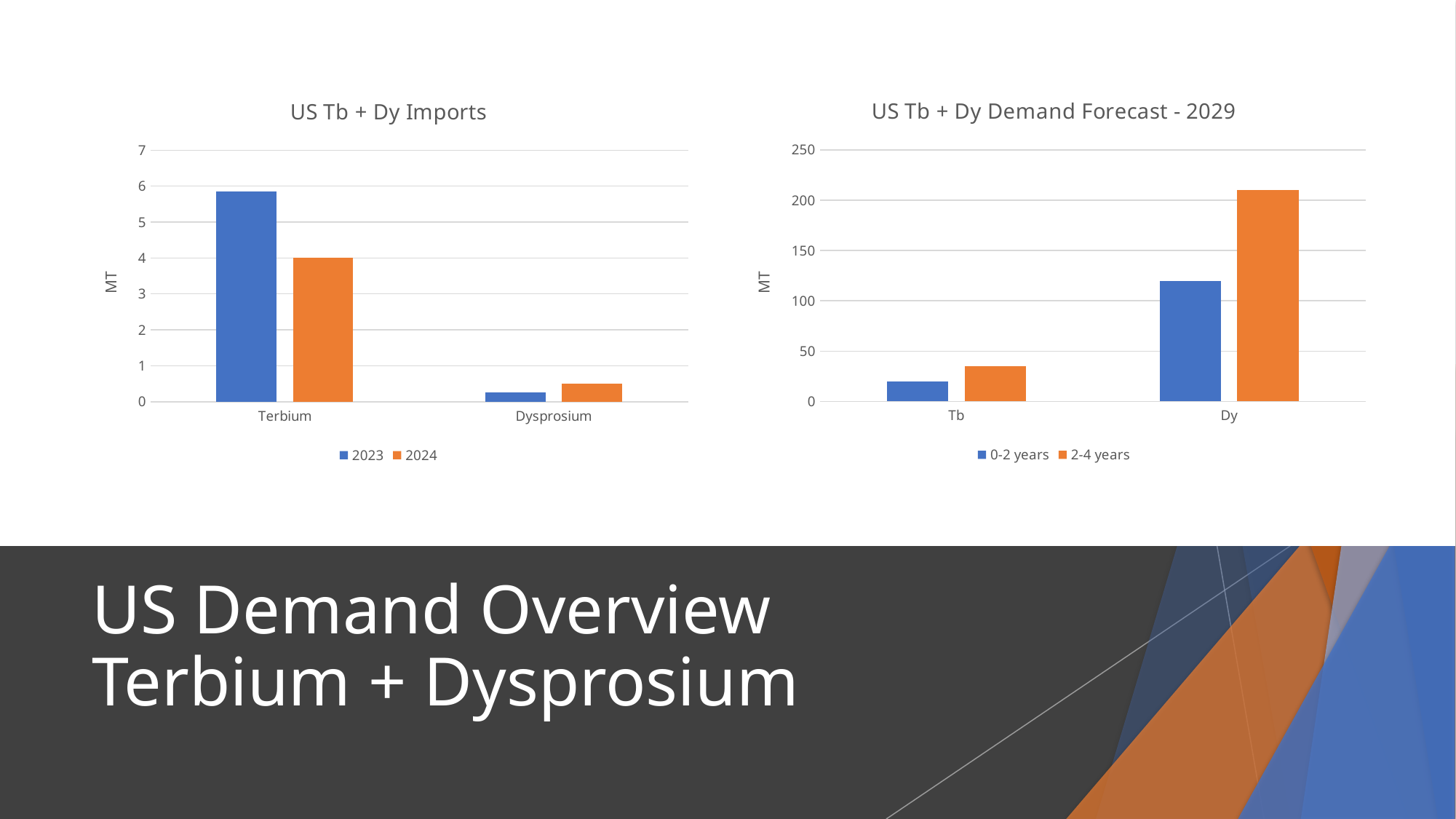
In the 'US Tb + Dy Demand Forecast - 2029' chart, which category has the lowest 0-2 years value? Tb In the 'US Tb + Dy Imports' chart, what kind of chart is shown? bar chart In the 'US Tb + Dy Imports' chart, which is larger for Terbium, the 2023 value or the 2024 value? 2023 In the 'US Tb + Dy Imports' chart, how many series does the legend list? 2 In the 'US Tb + Dy Imports' chart, how many categories are shown on the x axis? 2 In the 'US Tb + Dy Imports' chart, is the 2024 value for Dysprosium greater or less than 1? less In the 'US Tb + Dy Demand Forecast - 2029' chart, what is the label on the y axis? MT In the 'US Tb + Dy Demand Forecast - 2029' chart, which series does the orange bar represent? 2-4 years In the 'US Tb + Dy Imports' chart, which category has the highest 2023 value? Terbium In the 'US Tb + Dy Imports' chart, is the 2023 value for Terbium greater or less than 5? greater In the 'US Tb + Dy Demand Forecast - 2029' chart, is the 2-4 years value for Dy greater or less than 200? greater